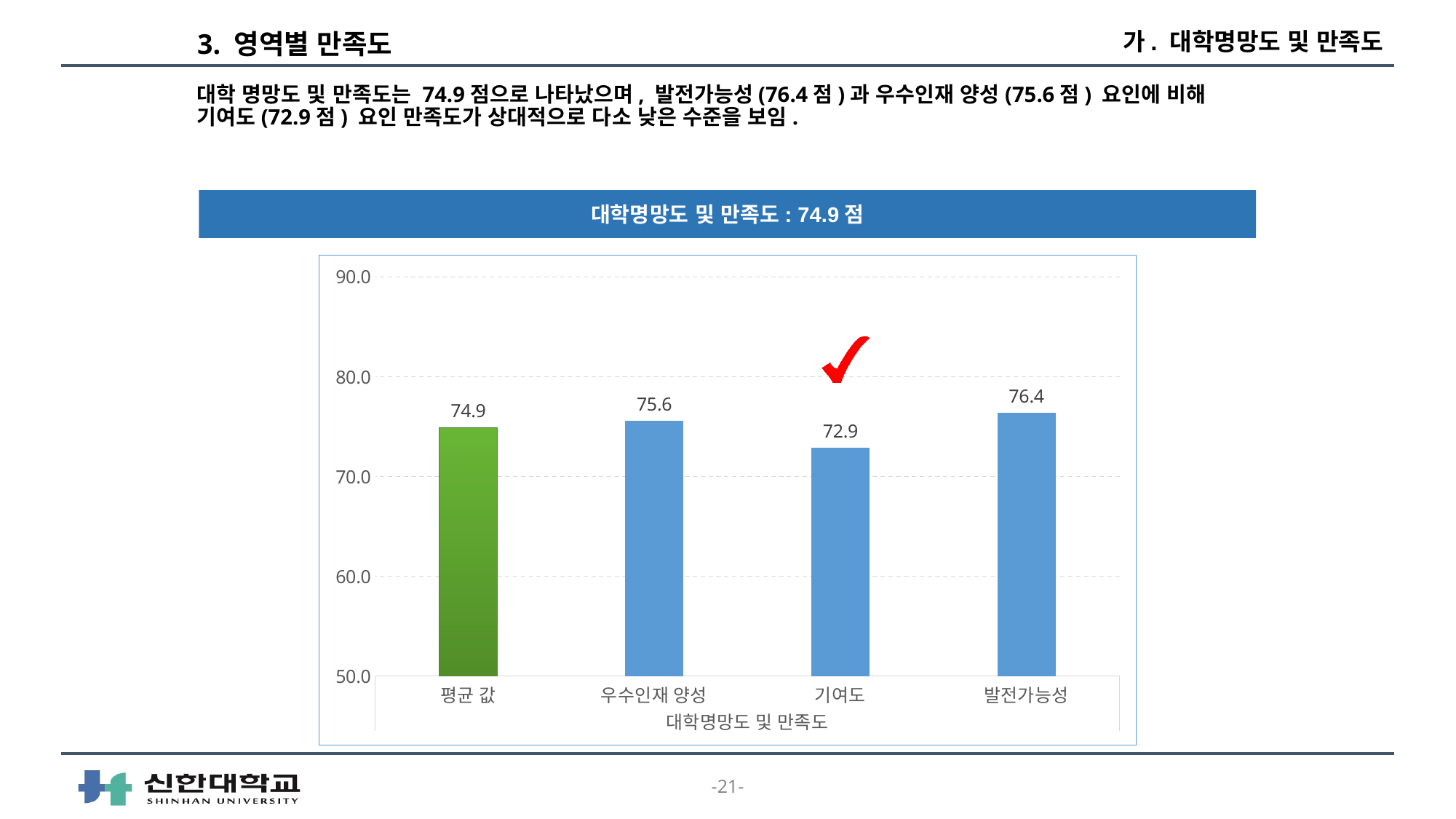
Is the value for 발전가능성 greater or less than 80.0? less What is the value for 우수인재 양성? 75.6 Which bar is coloured green rather than blue? 평균 값 What kind of chart is shown? bar chart What is the value for 평균 값? 74.9 Which category has the highest value? 발전가능성 What is the difference between the values for 발전가능성 and 기여도? 3.5 Which category has the lowest value? 기여도 What is the value for 기여도? 72.9 What is the value for 발전가능성? 76.4 Which is larger, the value for 우수인재 양성 or the value for 기여도? 우수인재 양성 How many categories are shown on the x axis? 4